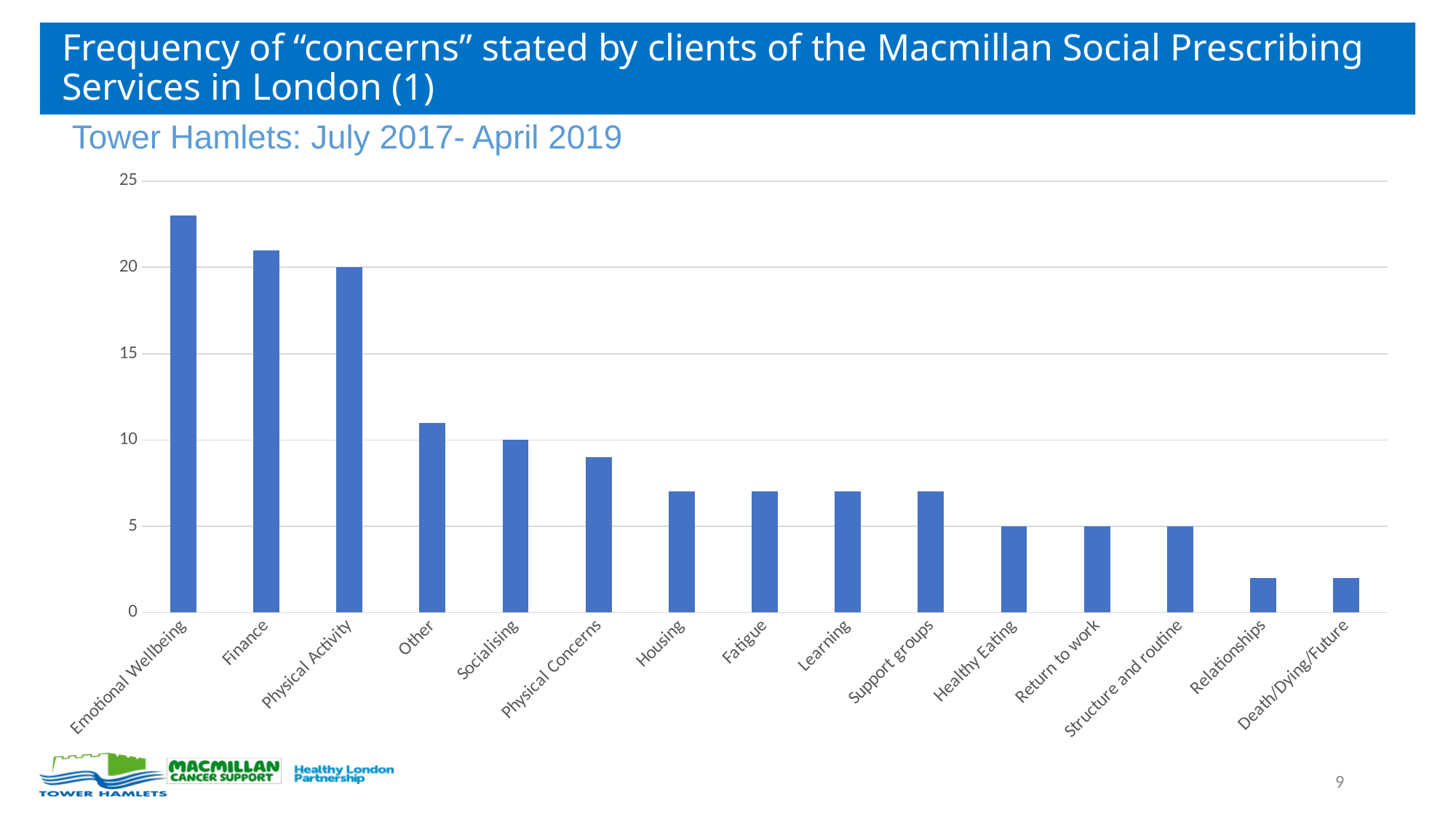
Which is larger, the value for Finance or the value for Other? Finance What is the value for Physical Activity? 20 What type of chart is shown on the slide? bar chart Is the value for Relationships greater or less than 5? less How many concern categories are shown on the x axis? 15 Is the value for Physical Concerns greater or less than 10? less Is the value for Emotional Wellbeing greater or less than 20? greater What is the value for Healthy Eating? 5 Which concern has the highest frequency? Emotional Wellbeing What is the difference between the values for Physical Activity and Socialising? 10 Do the values generally rise or fall from left to right along the x axis? fall What is the value for Socialising? 10